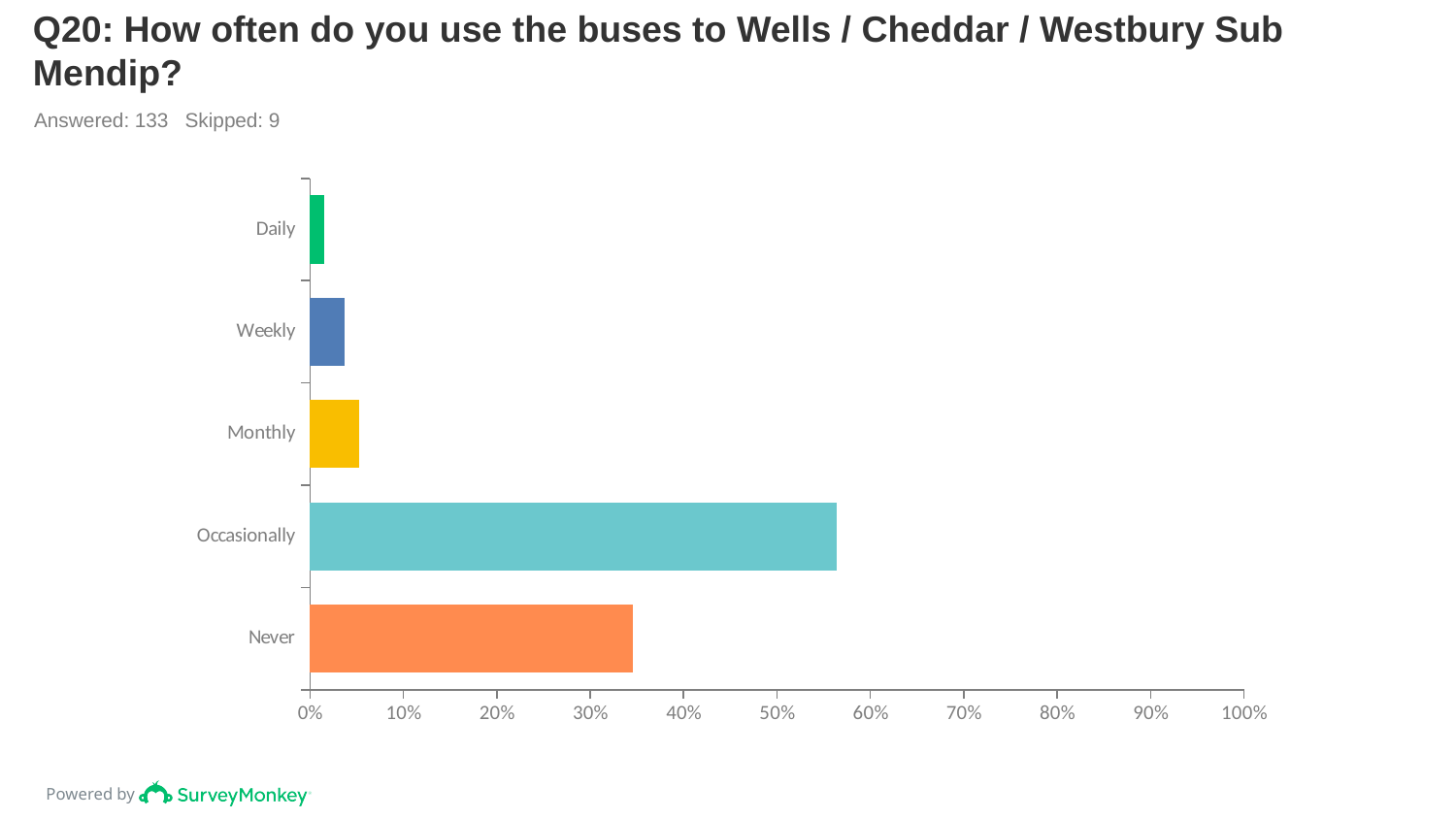
How many respondents answered this question? 133 Which is larger, the value for Occasionally or the value for Never? Occasionally What is the title of the chart? Q20: How often do you use the buses to Wells / Cheddar / Westbury Sub Mendip? Is the value for Never greater or less than 40%? less Is the value for Never greater or less than 30%? greater How many categories are shown on the chart? 5 Is the value for Occasionally greater or less than 50%? greater Which is larger, the value for Weekly or the value for Monthly? Monthly What kind of chart is shown on the slide? bar chart Which category has the highest value? Occasionally Which category has the lowest value? Daily